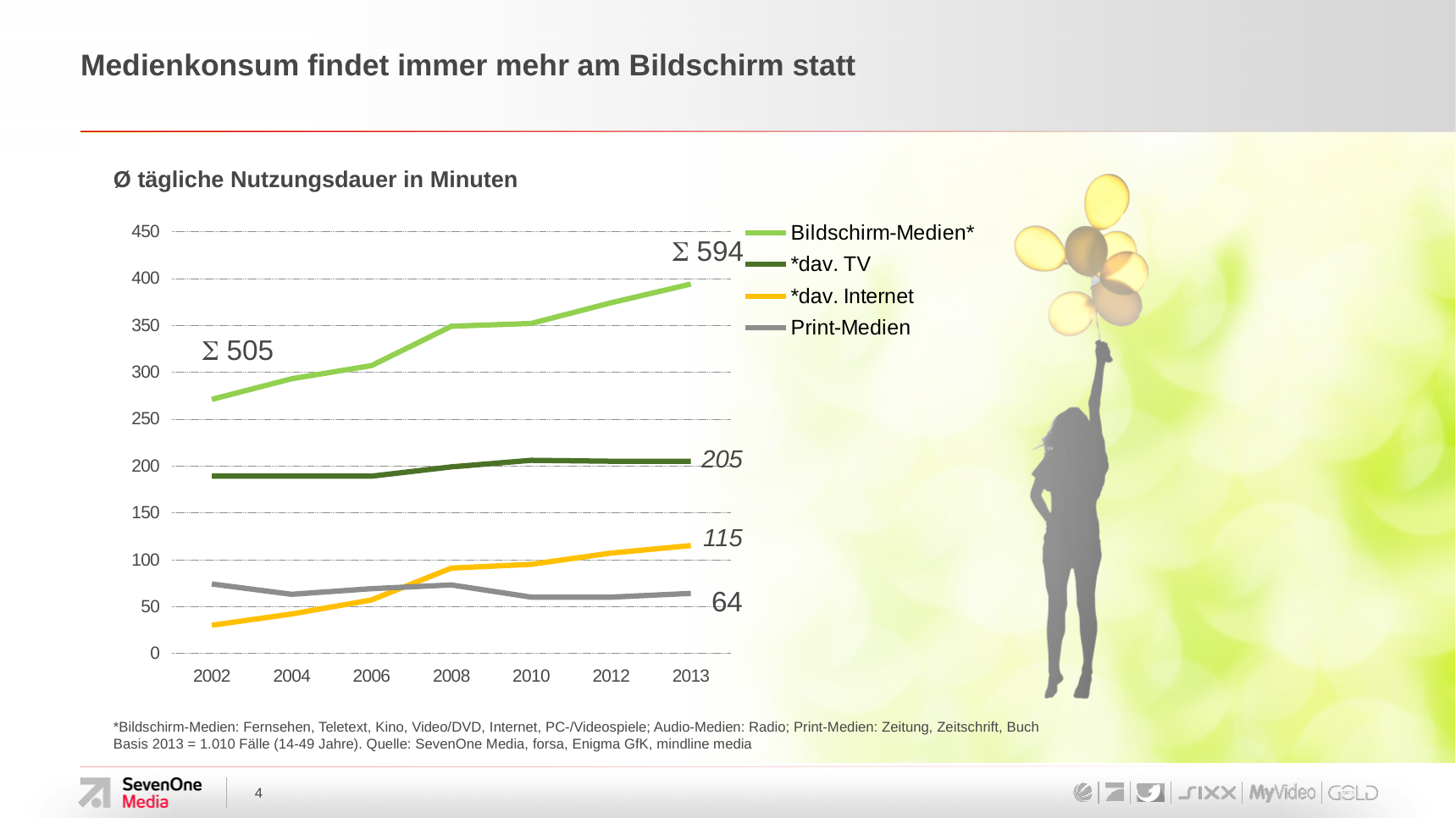
Which is larger in 2013, *dav. Internet or Print-Medien? *dav. Internet Is the value for *dav. Internet in 2002 greater or less than 50? less What is the value for *dav. Internet in 2013? 115 Which series has the highest value in 2013? Bildschirm-Medien* How many years are shown on the x axis? 7 Do the values for Bildschirm-Medien* rise or fall from 2002 to 2013? rise What is the value for *dav. TV in 2013? 205 What is the value for Print-Medien in 2013? 64 What kind of chart is shown on the slide? line chart How many series does the legend list? 4 Is the value for Bildschirm-Medien* in 2013 greater or less than 350? greater What is the difference between *dav. TV and *dav. Internet in 2013? 90